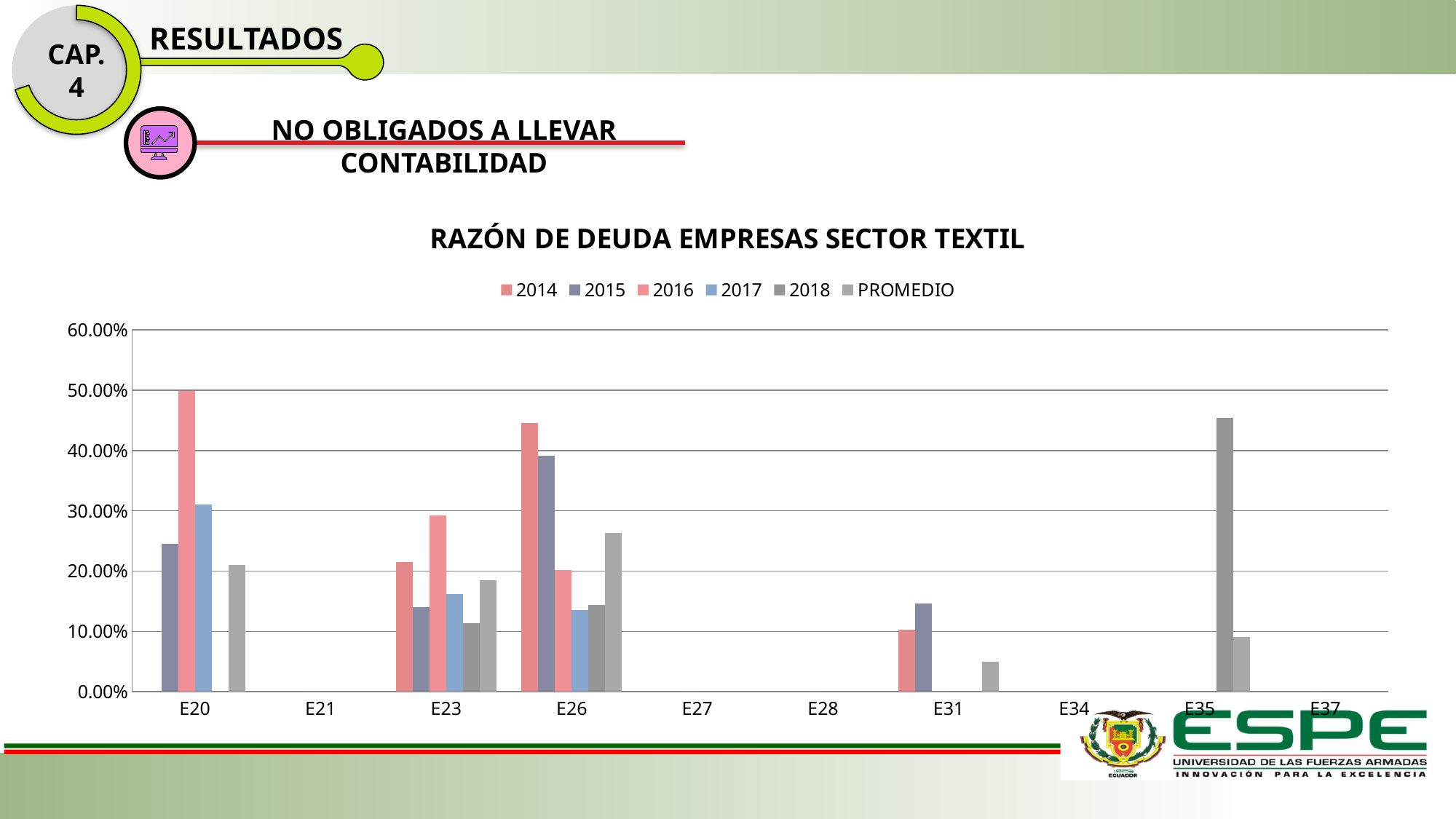
For E26, which is larger, the 2014 value or the 2015 value? 2014 Which category has the highest PROMEDIO bar? E26 How many series does the legend list? 6 Which series is listed last in the legend? PROMEDIO Is the 2018 value for E35 greater or less than 40.00%? greater What is the title of the chart? RAZÓN DE DEUDA EMPRESAS SECTOR TEXTIL Which is larger, the 2016 value for E20 or the 2018 value for E35? 2016 value for E20 Is the PROMEDIO value for E31 greater or less than 10.00%? less How many categories are shown on the x axis? 10 Is the 2014 value for E26 greater or less than 40.00%? greater What type of chart is shown on the slide? bar chart